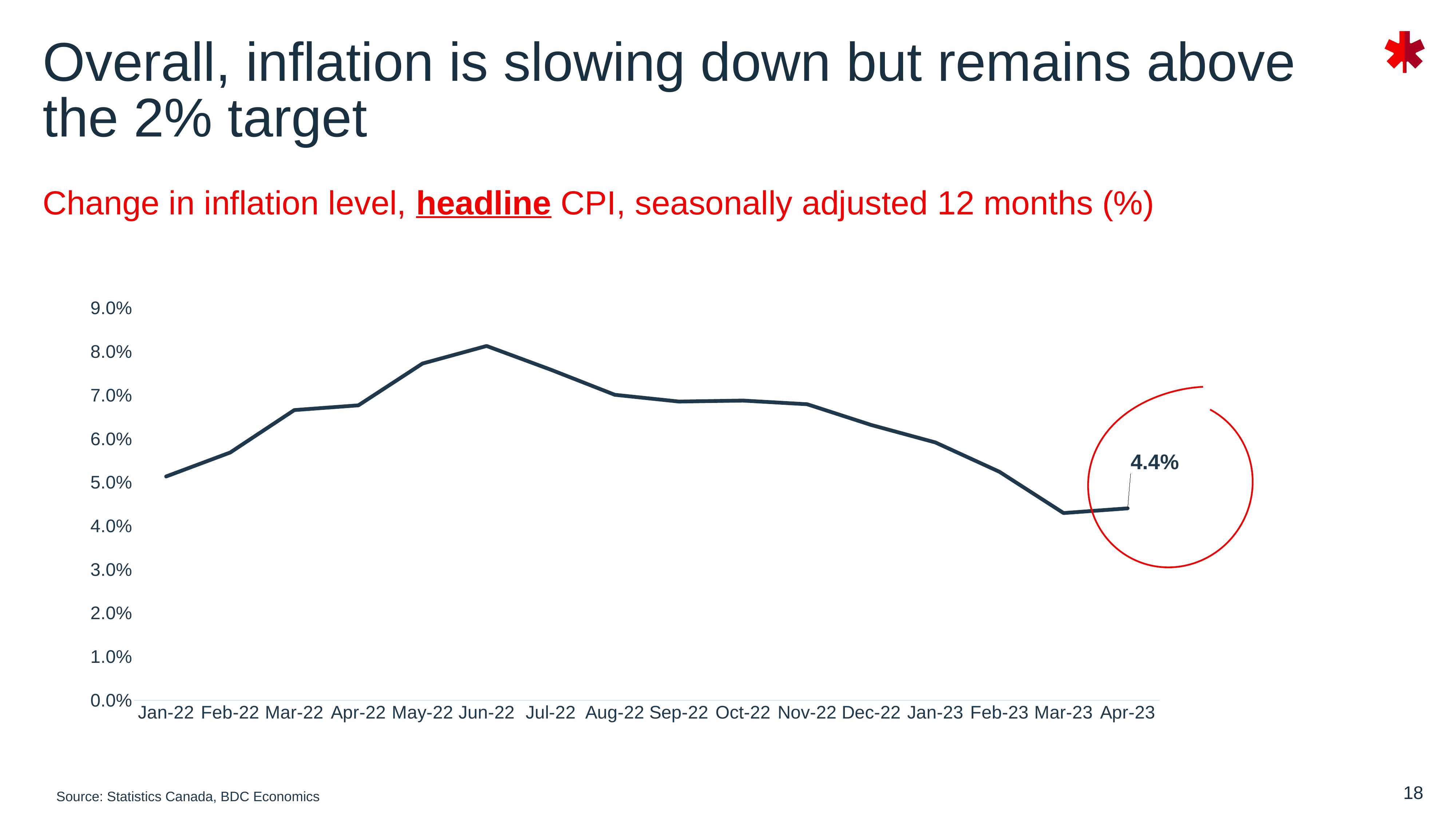
What is the source cited for the chart? Statistics Canada, BDC Economics What is the value for Apr-23? 4.4% Is the value for Jun-22 greater or less than 7.0%? greater Is the value for Dec-22 greater or less than 7.0%? less Between Jun-22 and Mar-23, do the values rise or fall? fall How many months are plotted on the x axis? 16 Which is larger, the value for Oct-22 or the value for Jan-23? Oct-22 Is the value for Mar-22 greater or less than 6.0%? greater Which month has the highest value? Jun-22 What kind of chart is shown on the slide? Line chart Which is larger, the value for Jun-22 or the value for Jan-22? Jun-22